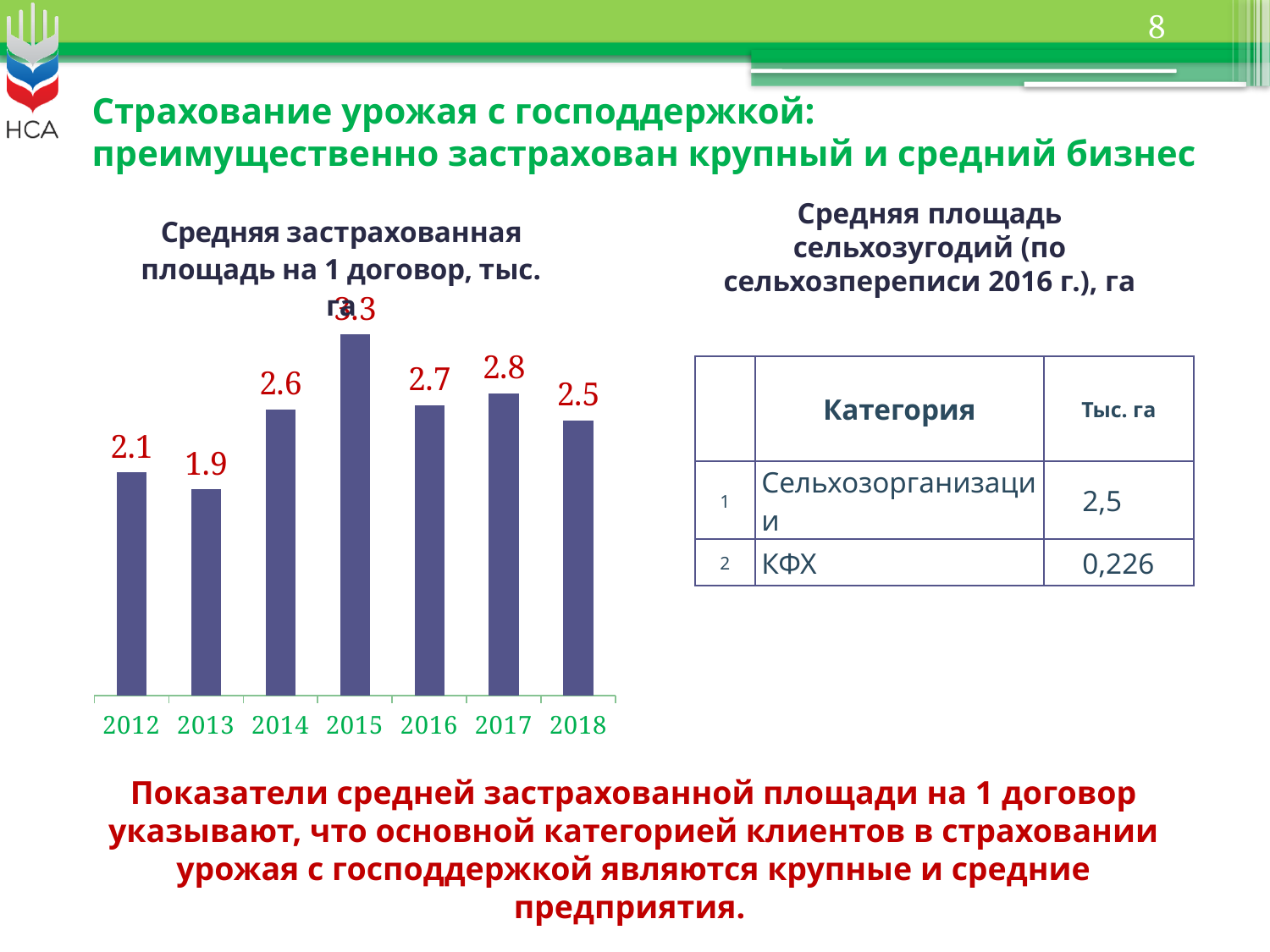
What is the difference between the values for 2015 and 2013? 1.4 Does the value rise or fall from 2012 to 2013? fall Which is larger, the value for 2014 or the value for 2018? 2014 What is the value for 2012 in the chart? 2.1 Which year has the highest value in the chart? 2015 Which year has the lowest value in the chart? 2013 What is the title of the chart? Средняя застрахованная площадь на 1 договор, тыс. га What is the value for 2018 in the chart? 2.5 What kind of chart is shown on the slide? bar chart What is the difference between the values for 2017 and 2016? 0.1 How many years are shown on the x axis of the chart? 7 What is the value for 2015 in the chart? 3.3